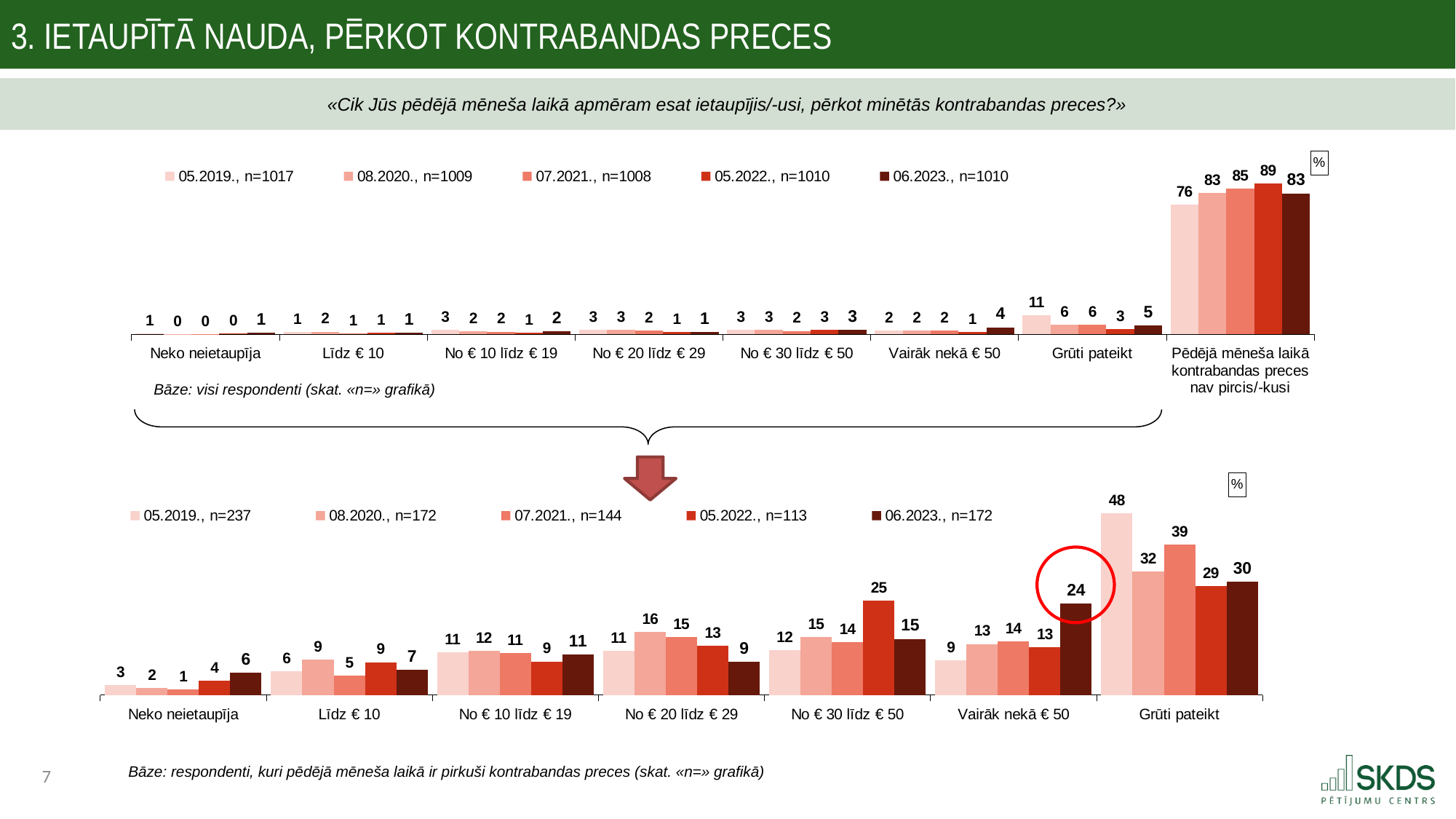
In the top chart (all respondents), what is the difference between the 05.2022 and 05.2019 values for 'Pēdējā mēneša laikā kontrabandas preces nav pircis/-kusi'? 13 In the bottom chart (respondents who bought contraband), which series has the lowest value for 'Neko neietaupīja'? 07.2021., n=144 In the bottom chart (respondents who bought contraband), which is larger: the 08.2020 value for 'No € 20 līdz € 29' or the 06.2023 value for 'No € 20 līdz € 29'? 08.2020 In the top chart (all respondents), which series has the highest value for 'Pēdējā mēneša laikā kontrabandas preces nav pircis/-kusi'? 05.2022., n=1010 In the bottom chart (respondents who bought contraband), what is the value for 'Vairāk nekā € 50' in the 06.2023 series? 24 What type of chart is the bottom chart (respondents who bought contraband)? Bar chart In the bottom chart (respondents who bought contraband), which series has the highest value for 'No € 30 līdz € 50'? 05.2022., n=113 In the top chart (all respondents), what is the value for 'Grūti pateikt' in the 05.2019 series? 11 In the top chart (all respondents), what is the value for 'Pēdējā mēneša laikā kontrabandas preces nav pircis/-kusi' in the 05.2022 series? 89 In the bottom chart (respondents who bought contraband), how many categories are shown on the x axis? 7 In the top chart (all respondents), how many series does the legend list? 5 In the bottom chart (respondents who bought contraband), what is the value for 'Grūti pateikt' in the 05.2019 series? 48